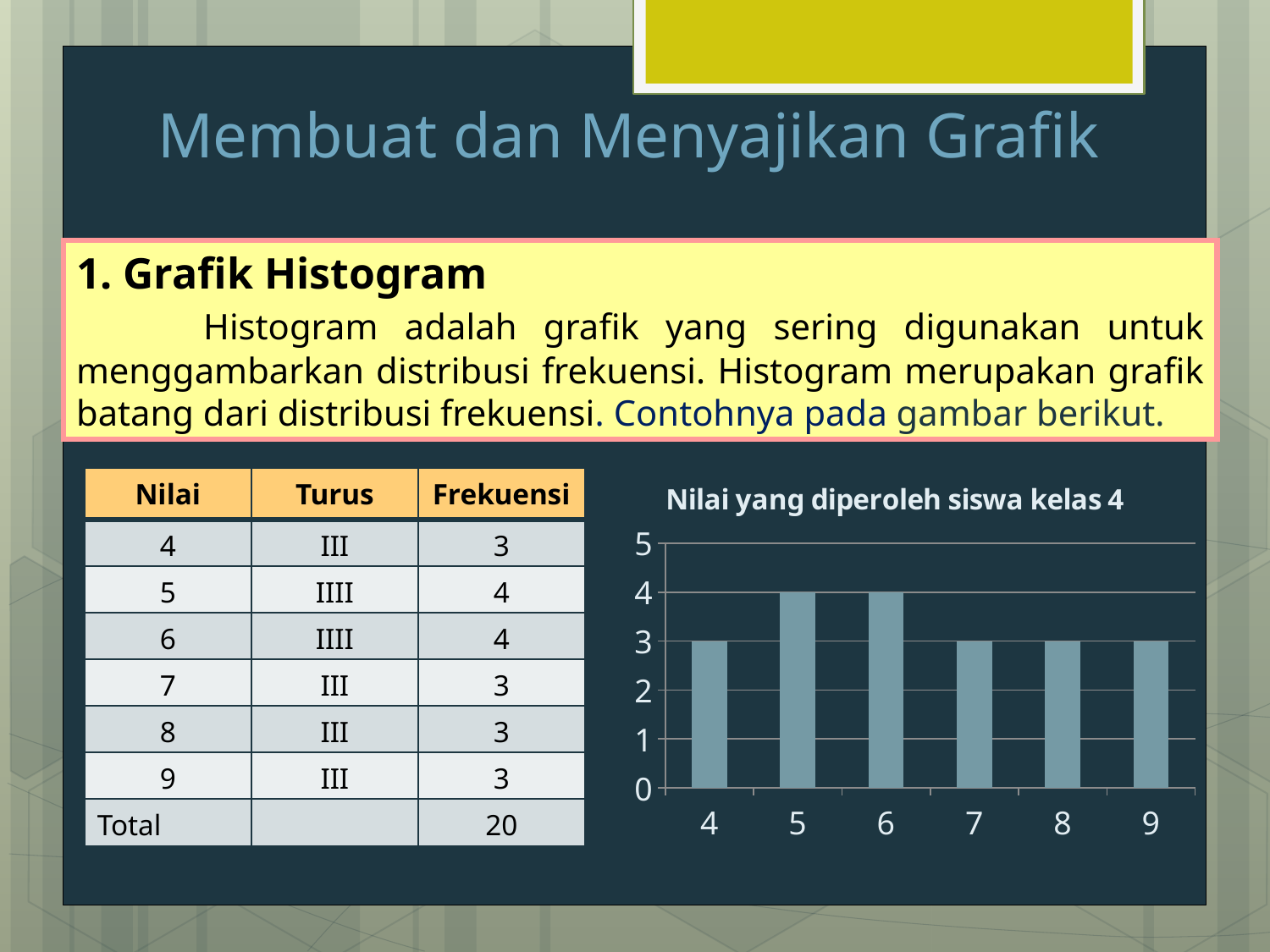
Which is larger in the chart, the bar for category 6 or the bar for category 8? 6 What is the value of the bar for category 4 in the chart? 3 What is the difference between the bar for category 6 and the bar for category 7 in the chart? 1 What is the value of the bar for category 5 in the chart 'Nilai yang diperoleh siswa kelas 4'? 4 What is the value of the bar for category 7 in the chart? 3 What kind of chart is shown on the slide? bar chart Is the value for category 5 in the chart greater or less than 3? greater Do the bar values rise or fall from category 6 to category 7 in the chart? fall How many categories are shown on the x axis of the chart? 6 Which is larger in the chart, the bar for category 5 or the bar for category 4? 5 What is the title of the chart on the slide? Nilai yang diperoleh siswa kelas 4 What is the value of the bar for category 9 in the chart? 3